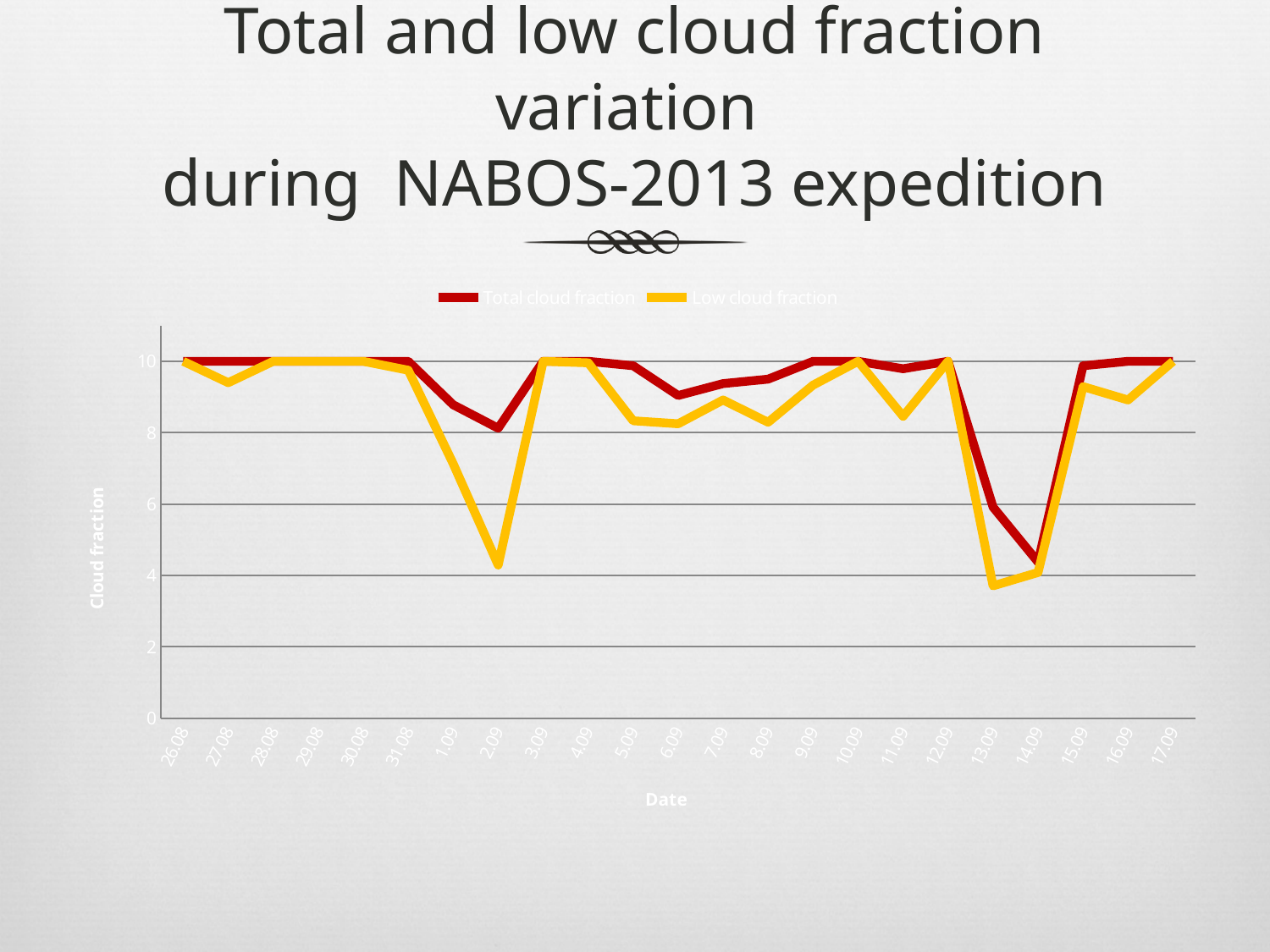
Is the Total cloud fraction value on 13.09 greater or less than 8? less Is the Low cloud fraction value on 2.09 greater or less than 6? less What is the Low cloud fraction value on 3.09? 10 How many dates are plotted along the x axis? 23 What kind of chart is shown on the slide? line chart How many series does the legend list? 2 What is the Total cloud fraction value on 26.08? 10 What is the label of the vertical axis? Cloud fraction On 2.09, which series has the larger value, Total cloud fraction or Low cloud fraction? Total cloud fraction On which date is the Total cloud fraction lowest? 14.09 What is the Total cloud fraction value on 12.09? 10 Is the Total cloud fraction value on 14.09 greater or less than 6? less